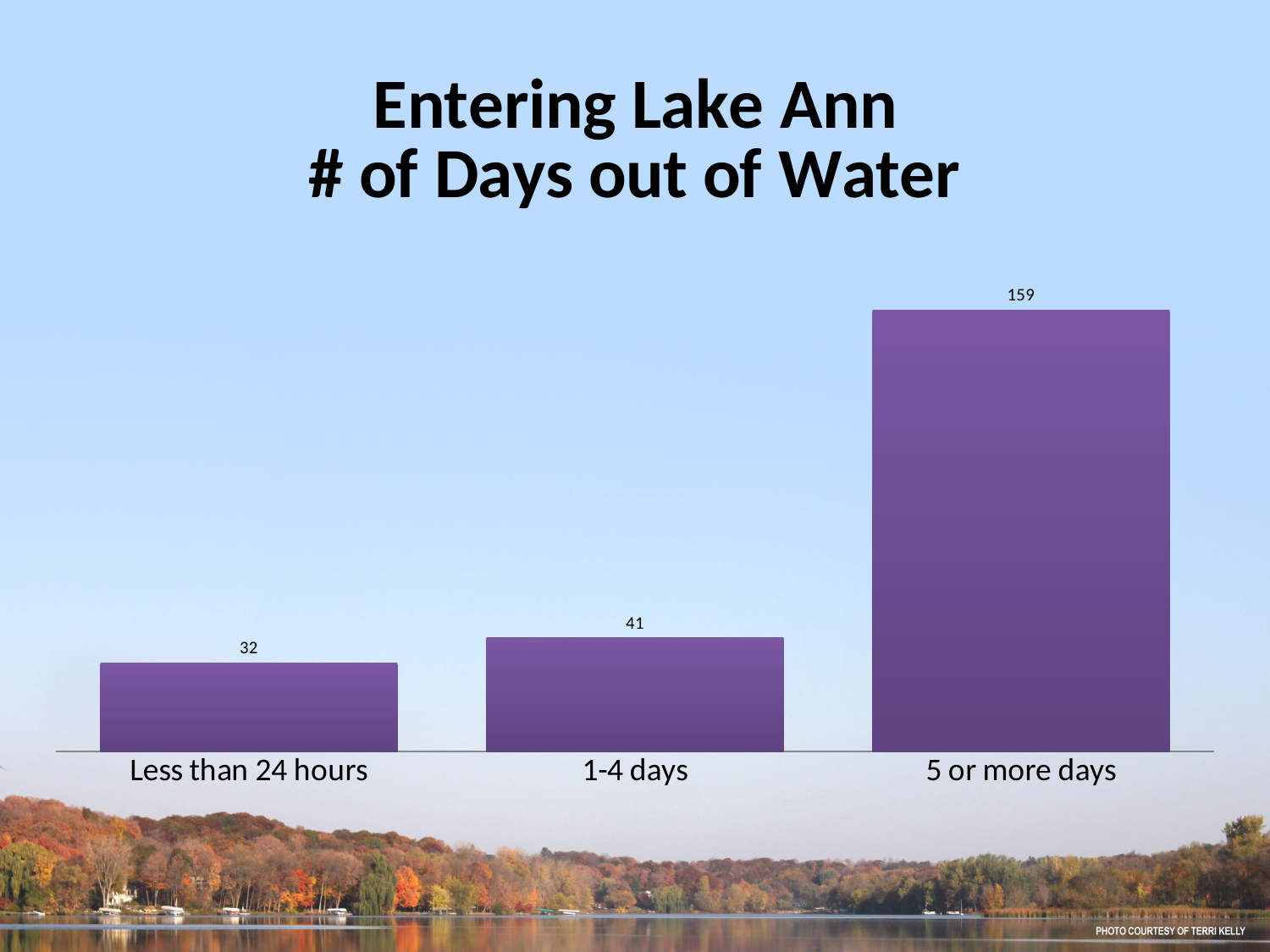
Do the values rise or fall from left to right across the categories? Rise What is the value for "Less than 24 hours"? 32 Which category has the lowest value? Less than 24 hours What is the title of the chart? Entering Lake Ann # of Days out of Water What is the difference between the values for "1-4 days" and "Less than 24 hours"? 9 What kind of chart is shown on the slide? Bar chart What is the difference between the values for "5 or more days" and "1-4 days"? 118 What is the value for "5 or more days"? 159 Which is larger, the value for "1-4 days" or the value for "Less than 24 hours"? 1-4 days What is the value for "1-4 days"? 41 Which category has the highest value? 5 or more days How many categories are shown on the chart? 3